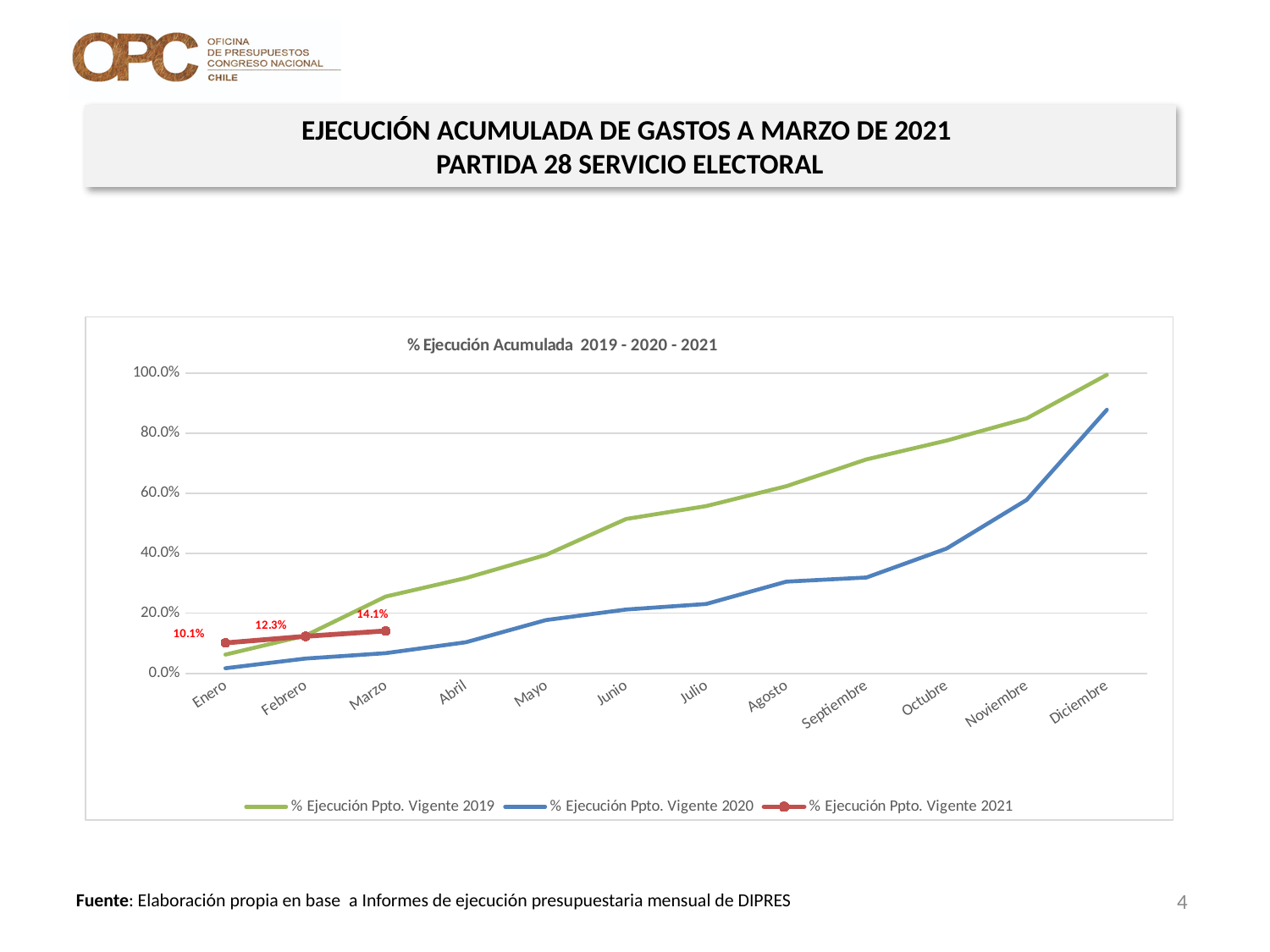
What is the value of % Ejecución Ppto. Vigente 2021 for Marzo? 14.1% Is the value for % Ejecución Ppto. Vigente 2020 in Diciembre greater or less than 80%? greater What is the difference between the 2021 values for Marzo and Enero? 4.0% How many months are shown on the x axis? 12 What kind of chart is shown on the slide? line chart How many series does the chart legend list? 3 What is the difference between the 2021 values for Febrero and Enero? 2.2% What is the title of the chart? % Ejecución Acumulada 2019 - 2020 - 2021 What is the value of % Ejecución Ppto. Vigente 2021 for Febrero? 12.3% What is the value of % Ejecución Ppto. Vigente 2021 for Enero? 10.1% Is the value for % Ejecución Ppto. Vigente 2020 in Junio greater or less than 40%? less Which series has the higher value in Diciembre, 2019 or 2020? % Ejecución Ppto. Vigente 2019